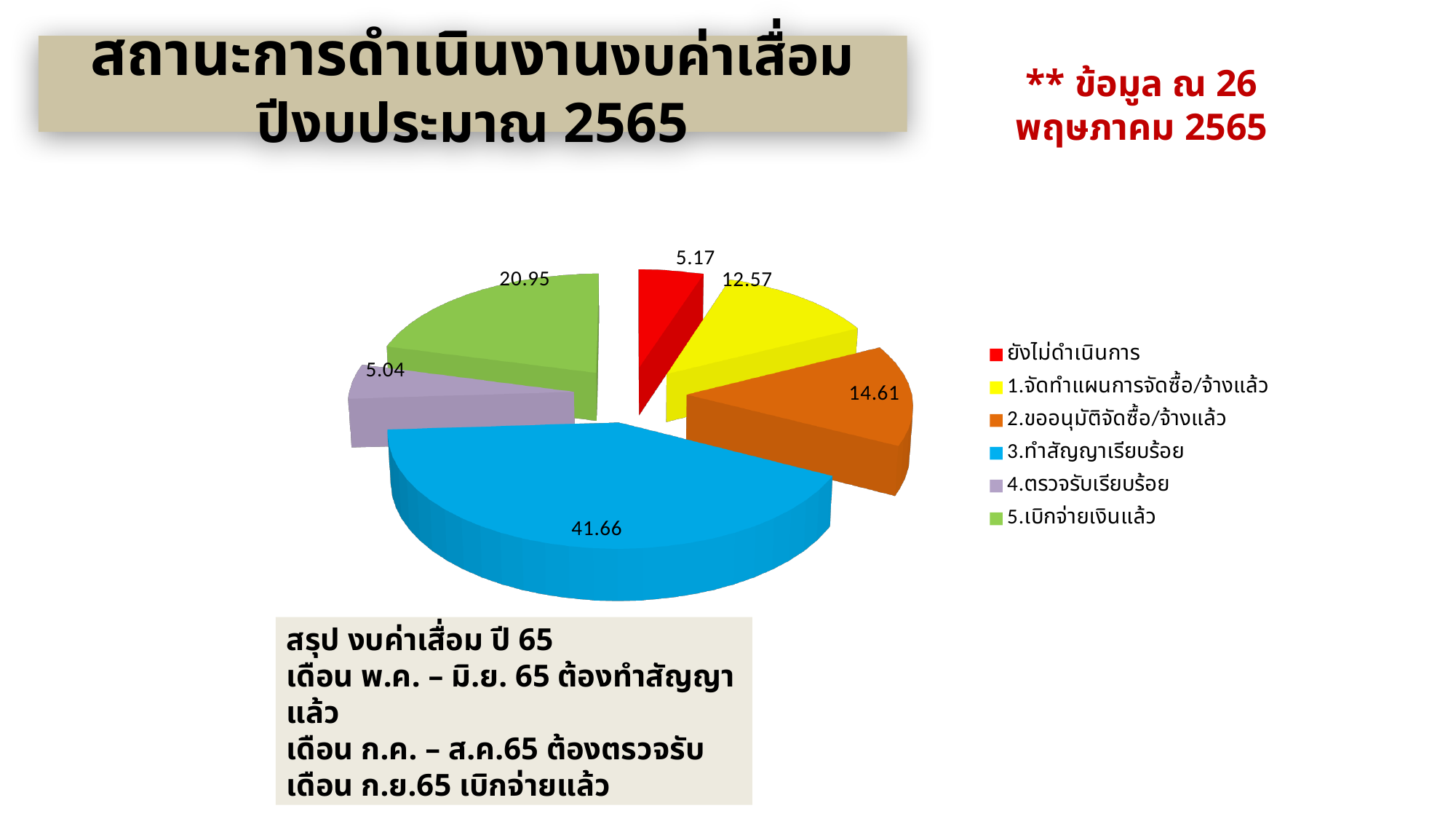
Which is larger, the value for 2.ขออนุมัติจัดซื้อ/จ้างแล้ว or the value for 1.จัดทำแผนการจัดซื้อ/จ้างแล้ว? 2.ขออนุมัติจัดซื้อ/จ้างแล้ว How many entries does the legend list? 6 What kind of chart is shown on the slide? pie chart What is the value for 3.ทำสัญญาเรียบร้อย? 41.66 How many slices does the pie chart have? 6 Which category has the largest slice? 3.ทำสัญญาเรียบร้อย What is the value for 5.เบิกจ่ายเงินแล้ว? 20.95 What is the difference between the values for 5.เบิกจ่ายเงินแล้ว and 1.จัดทำแผนการจัดซื้อ/จ้างแล้ว? 8.38 What colour is the slice for 4.ตรวจรับเรียบร้อย? purple What is the value for ยังไม่ดำเนินการ? 5.17 What is the value for 2.ขออนุมัติจัดซื้อ/จ้างแล้ว? 14.61 Which category has the smallest slice? 4.ตรวจรับเรียบร้อย